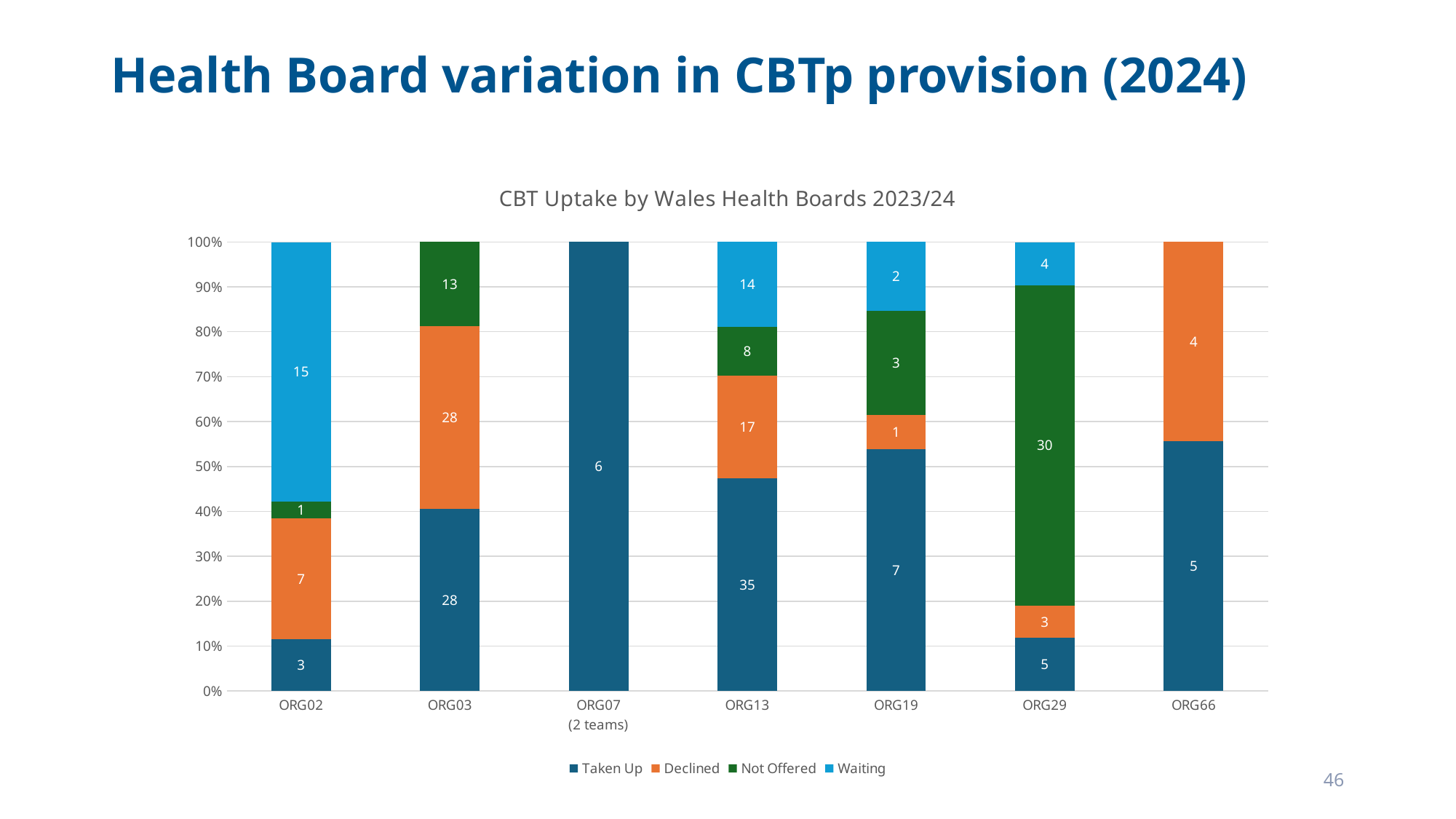
What is the total of the labelled values in the ORG19 bar? 13 Which is larger, the Not Offered value for ORG03 or the Not Offered value for ORG13? ORG03 What is the Taken Up value for ORG13? 35 What is the difference between the Waiting values for ORG02 and ORG13? 1 How many health boards are shown on the x axis? 7 What kind of chart is shown on the slide? Stacked bar chart What is the Waiting value for ORG02? 15 How many series does the legend list? 4 What is the Declined value for ORG03? 28 What is the Not Offered value for ORG29? 30 Which health board has the lowest Declined value among those with a Declined label? ORG19